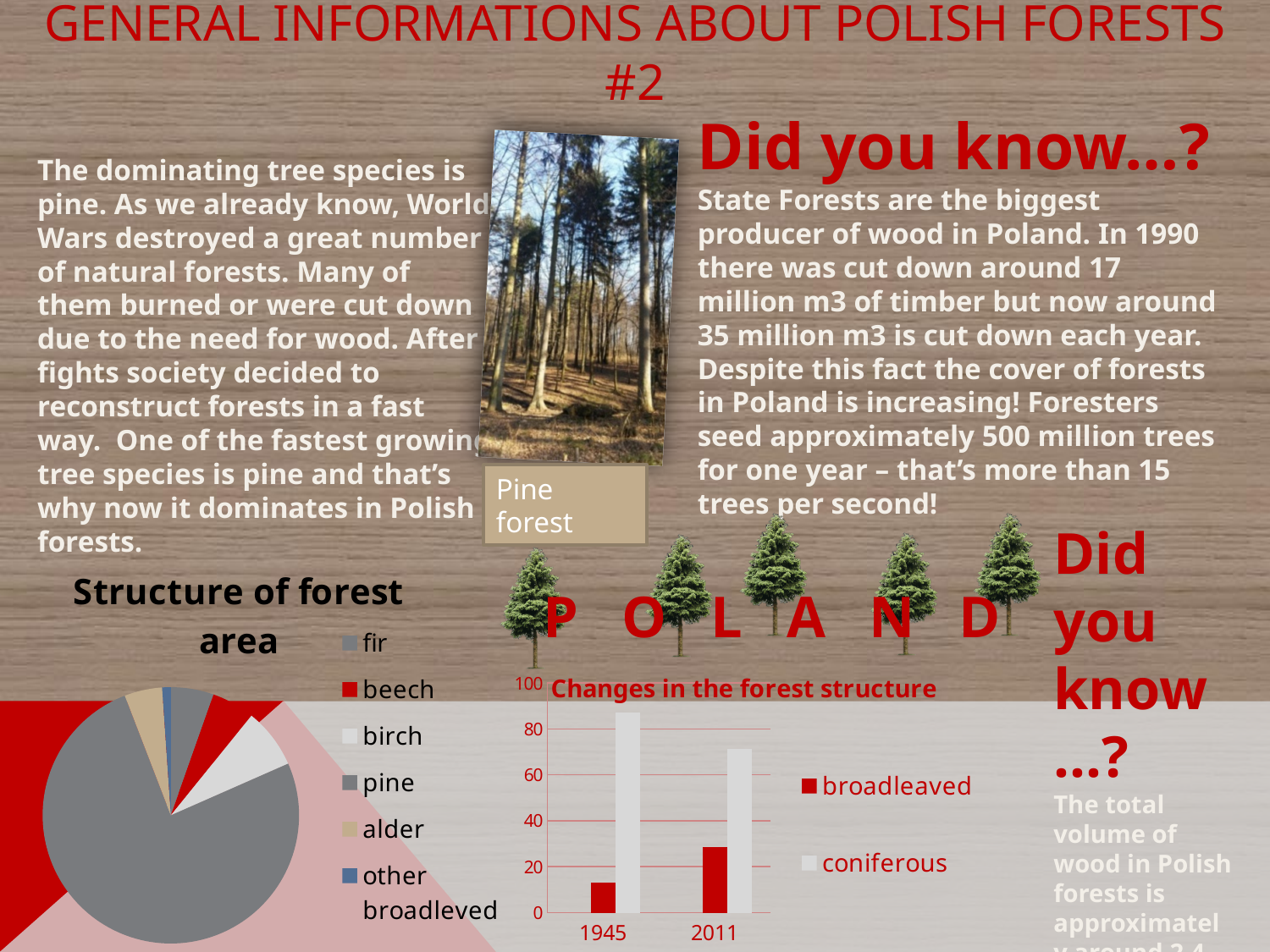
In the 'Changes in the forest structure' chart, is the coniferous value for 2011 greater or less than 60? greater In the 'Structure of forest area' pie chart, which tree species has the largest share? pine In the 'Structure of forest area' pie chart, which category has the smallest slice? other broadleved How many series does the legend of the 'Changes in the forest structure' chart list? 2 In the 'Changes in the forest structure' chart, is the coniferous value for 1945 greater or less than 80? greater What kind of chart is the 'Changes in the forest structure' chart? bar chart In the 'Changes in the forest structure' chart, is the broadleaved value for 1945 greater or less than 20? less What kind of chart is the 'Structure of forest area' chart? pie chart How many years are shown on the x axis of the 'Changes in the forest structure' chart? 2 In the 'Changes in the forest structure' chart, does the broadleaved share rise or fall from 1945 to 2011? rise How many categories does the legend of the 'Structure of forest area' pie chart list? 6 In the 'Changes in the forest structure' chart, which series is larger in 2011, broadleaved or coniferous? coniferous